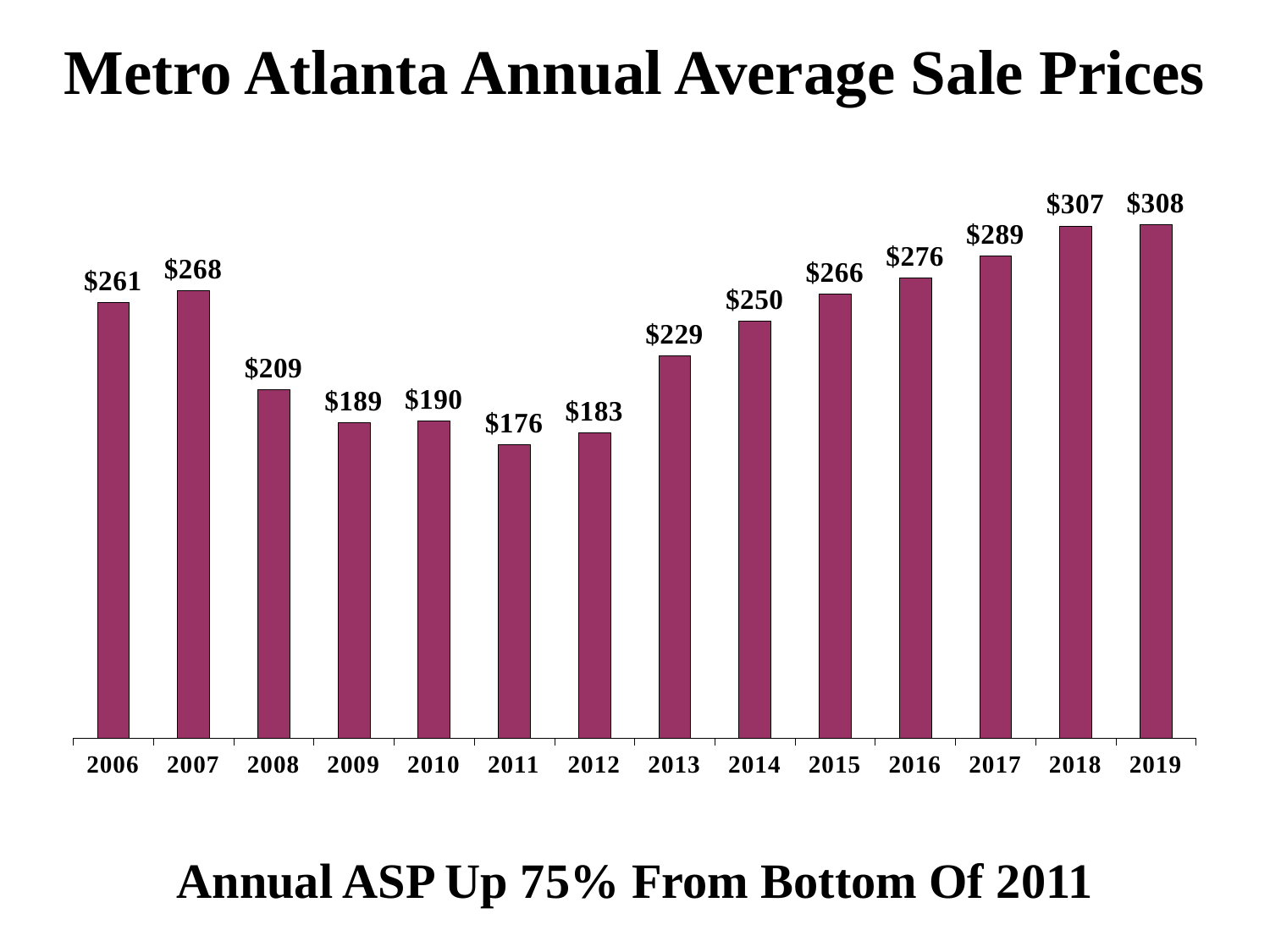
What is the difference between the 2007 value and the 2008 value? $59 Which year has a higher average sale price, 2009 or 2012? 2009 What is the average sale price shown for 2016? $276 What is the average sale price shown for 2011? $176 Which year has the highest average sale price? 2019 What kind of chart is shown on the slide? Bar chart Do the values rise or fall from 2011 to 2019? Rise Which year has the lowest average sale price? 2011 What is the title of the chart? Metro Atlanta Annual Average Sale Prices Which year has a higher average sale price, 2006 or 2015? 2015 How many years are shown on the chart? 14 What is the difference between the 2019 value and the 2011 value? $132